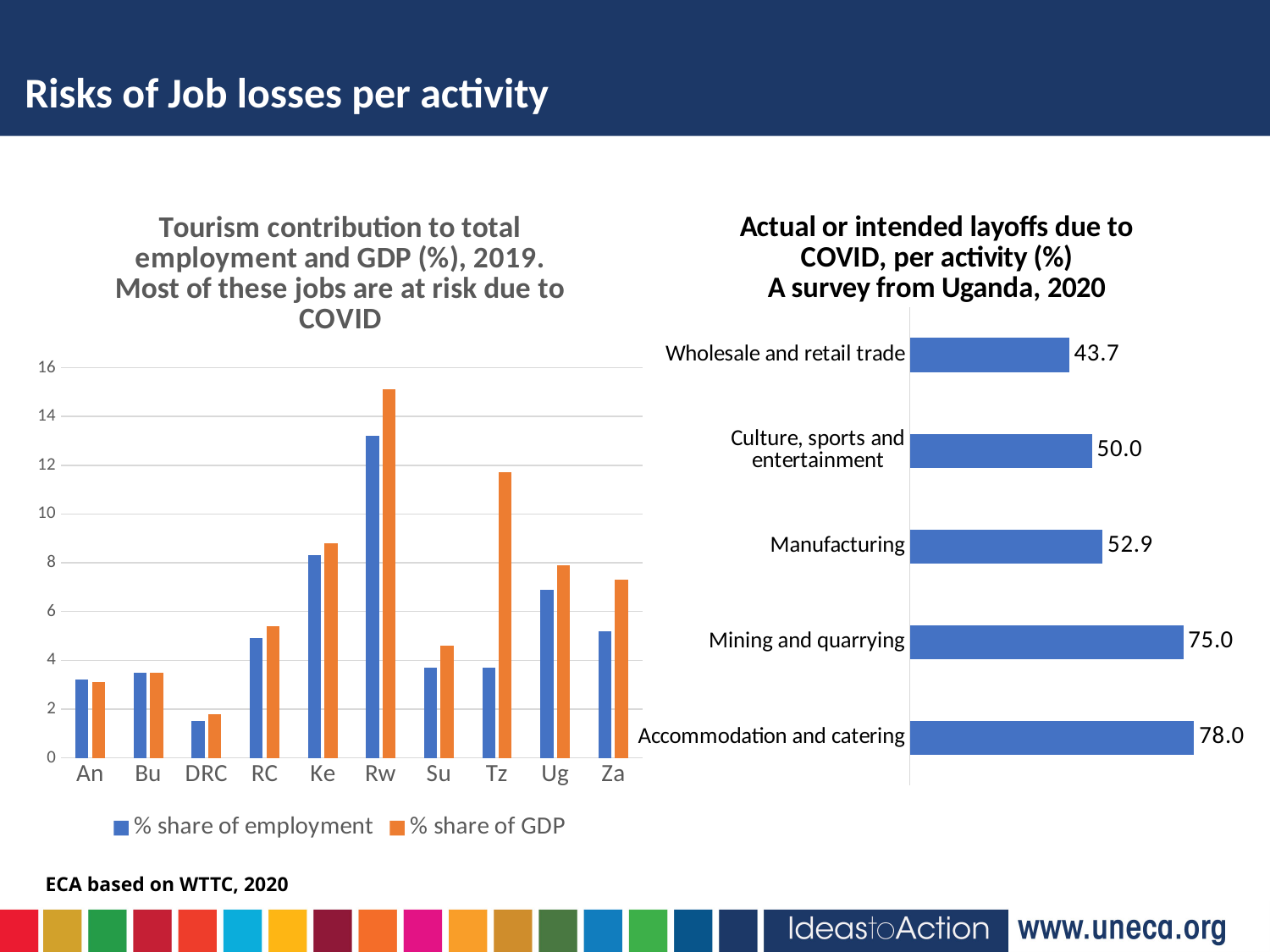
In the 'Tourism contribution to total employment and GDP' chart, is the % share of GDP for Tz greater or less than 10? greater What type of chart is the 'Tourism contribution to total employment and GDP' chart? Bar chart In the 'Actual or intended layoffs due to COVID' chart, which activity has the highest value? Accommodation and catering In the 'Tourism contribution to total employment and GDP' chart, which country has the lowest % share of employment? DRC In the 'Actual or intended layoffs due to COVID' chart, how many activities are shown? 5 In the 'Actual or intended layoffs due to COVID' chart, what is the value for Accommodation and catering? 78.0 In the 'Actual or intended layoffs due to COVID' chart, which activity has the lowest value? Wholesale and retail trade In the 'Tourism contribution to total employment and GDP' chart, which country has the highest % share of GDP? Rw In the 'Tourism contribution to total employment and GDP' chart, how many series does the legend list? 2 In the 'Actual or intended layoffs due to COVID' chart, what is the difference between Mining and quarrying and Manufacturing? 22.1 In the 'Actual or intended layoffs due to COVID' chart, what is the value for Wholesale and retail trade? 43.7 In the 'Tourism contribution to total employment and GDP' chart, is the % share of employment for Ug greater or less than 8? less